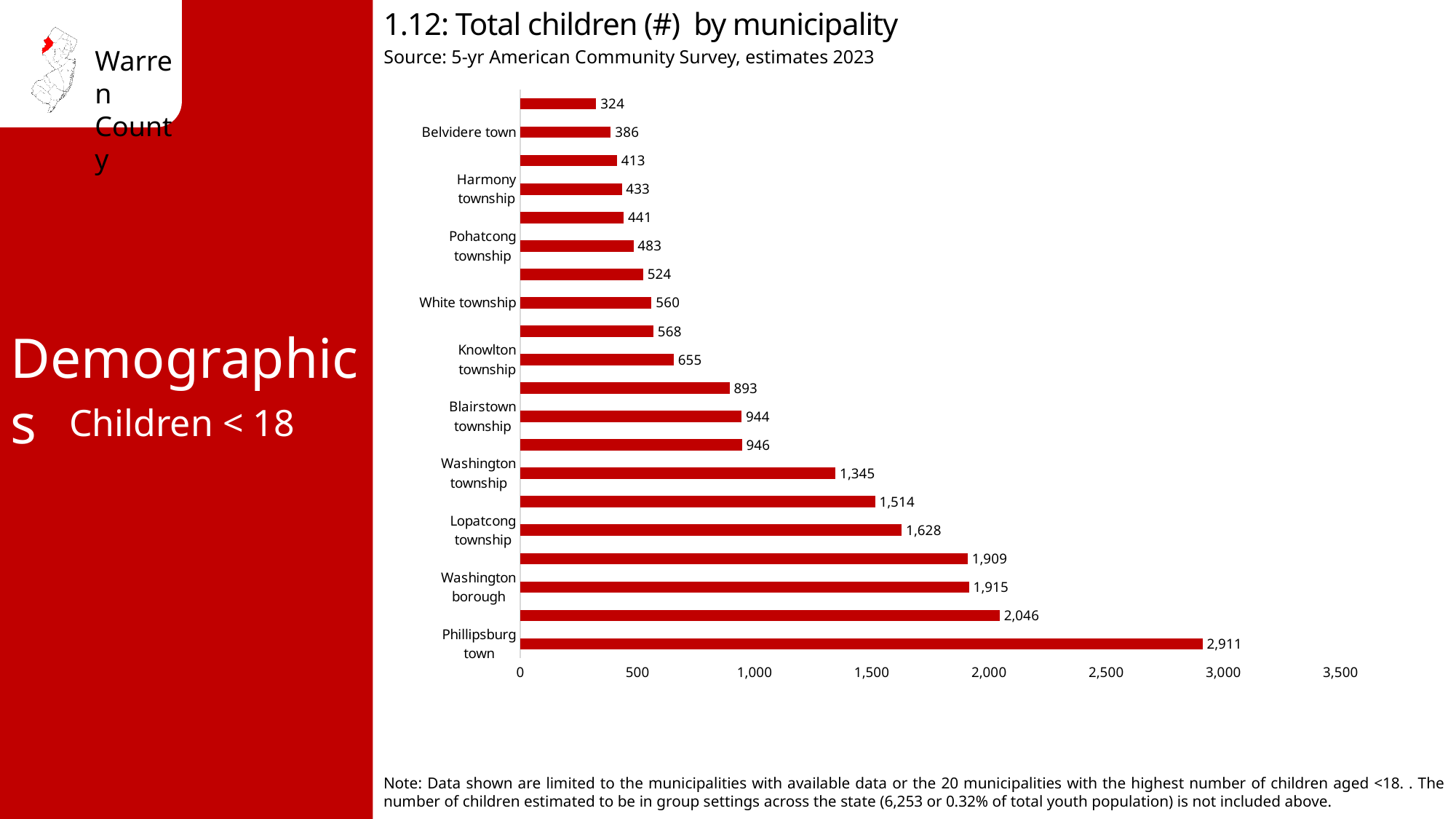
Which has more children, Knowlton township or Blairstown township? Blairstown township What type of chart is shown on the slide? Bar chart What is the source cited for the chart? 5-yr American Community Survey, estimates 2023 Which municipality has the highest number of children? Phillipsburg town What is the value for Lopatcong township? 1,628 What is the total number of children for Phillipsburg town? 2,911 Is the value for White township greater or less than 500? greater How many bars are plotted on the chart? 20 What is the difference between the values for Phillipsburg town and Washington borough? 996 What is the value shown for Belvidere town? 386 What is the smallest value shown on the chart? 324 How many children are shown for Washington township? 1,345